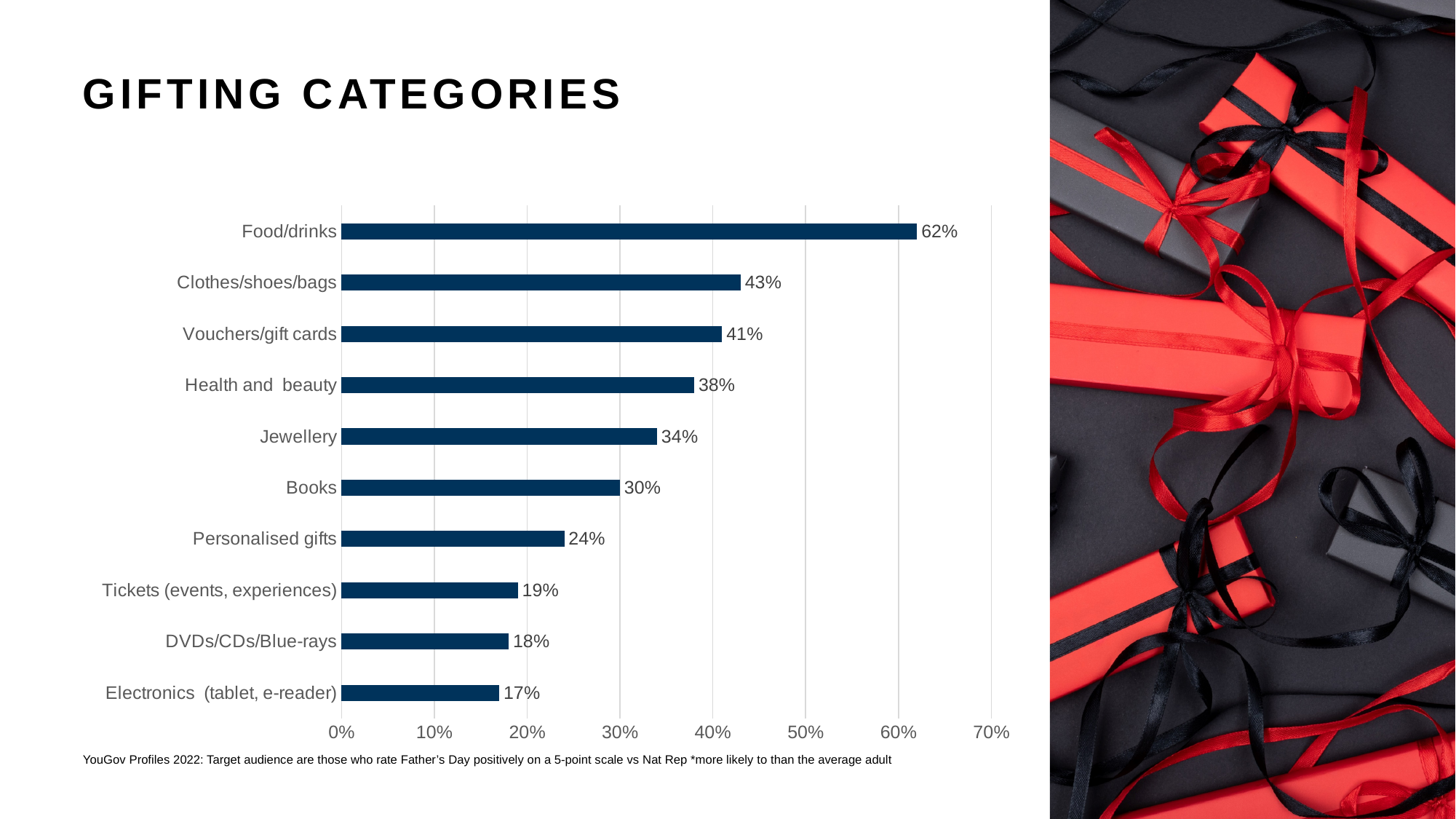
Which category has the highest value? Food/drinks How many categories are shown in the chart? 10 What is the title of the slide? GIFTING CATEGORIES Which is larger, Health and beauty or Vouchers/gift cards? Vouchers/gift cards What is the difference between Food/drinks and Clothes/shoes/bags? 19% What is the value for Food/drinks? 62% What is the value for Tickets (events, experiences)? 19% Which category has the lowest value? Electronics (tablet, e-reader) What is the value for Jewellery? 34% Is the value for Personalised gifts greater or less than 30%? less What is the difference between Books and Personalised gifts? 6% What kind of chart is shown on the slide? Bar chart